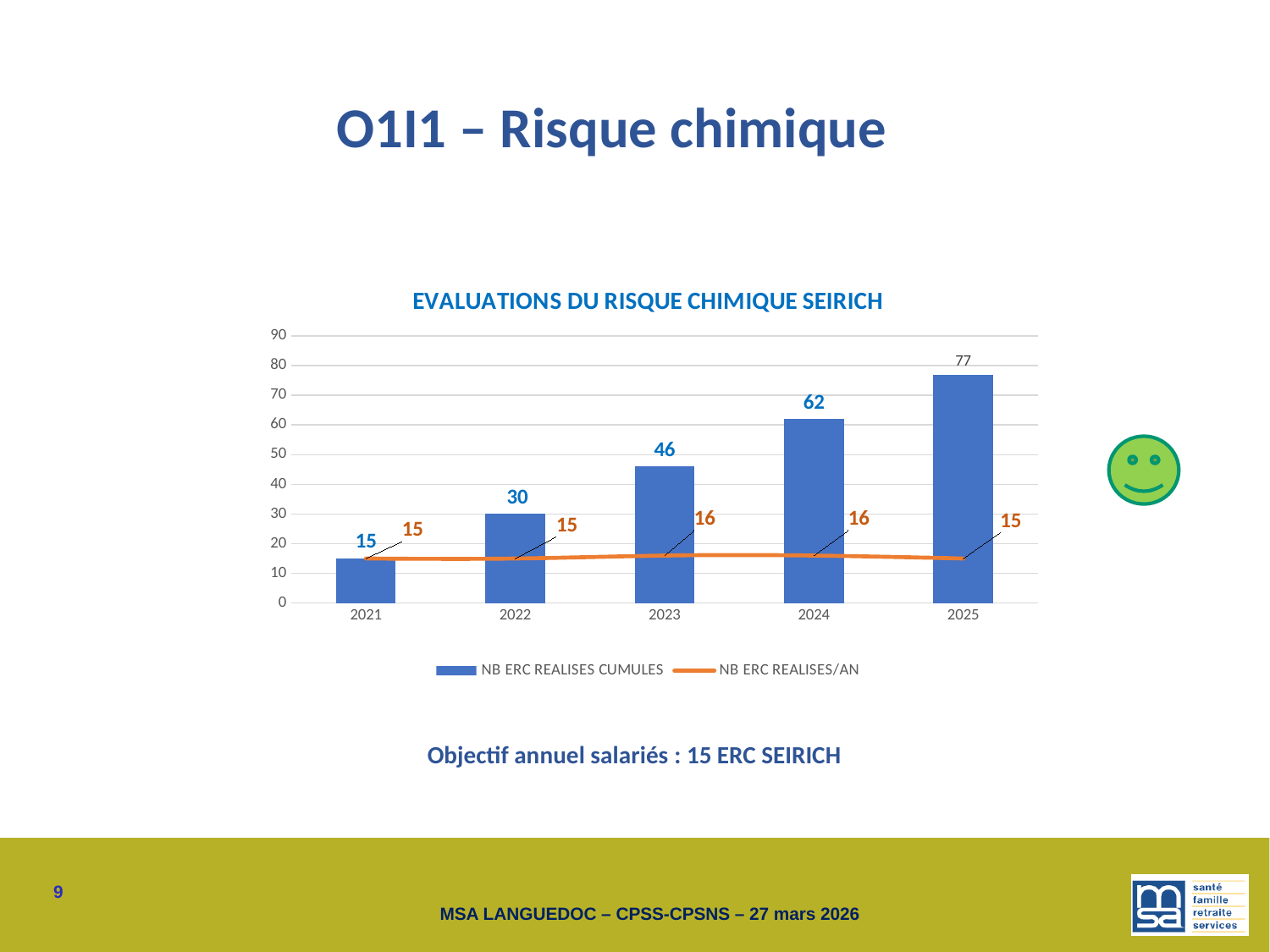
Which year has the highest value of NB ERC REALISES CUMULES? 2025 Does NB ERC REALISES CUMULES rise or fall from 2021 to 2025? Rise What is the value of NB ERC REALISES/AN for 2023? 16 What kind of chart is used for the NB ERC REALISES CUMULES series? Bar chart What is the value of NB ERC REALISES CUMULES for 2025? 77 Which is larger: NB ERC REALISES CUMULES in 2023 or in 2022? 2023 How many series does the legend list? 2 What is the title of the chart? EVALUATIONS DU RISQUE CHIMIQUE SEIRICH What is the difference between NB ERC REALISES CUMULES in 2024 and in 2023? 16 How many years are shown on the x axis? 5 What is the value of NB ERC REALISES CUMULES for 2022? 30 Which year has the lowest value of NB ERC REALISES CUMULES? 2021